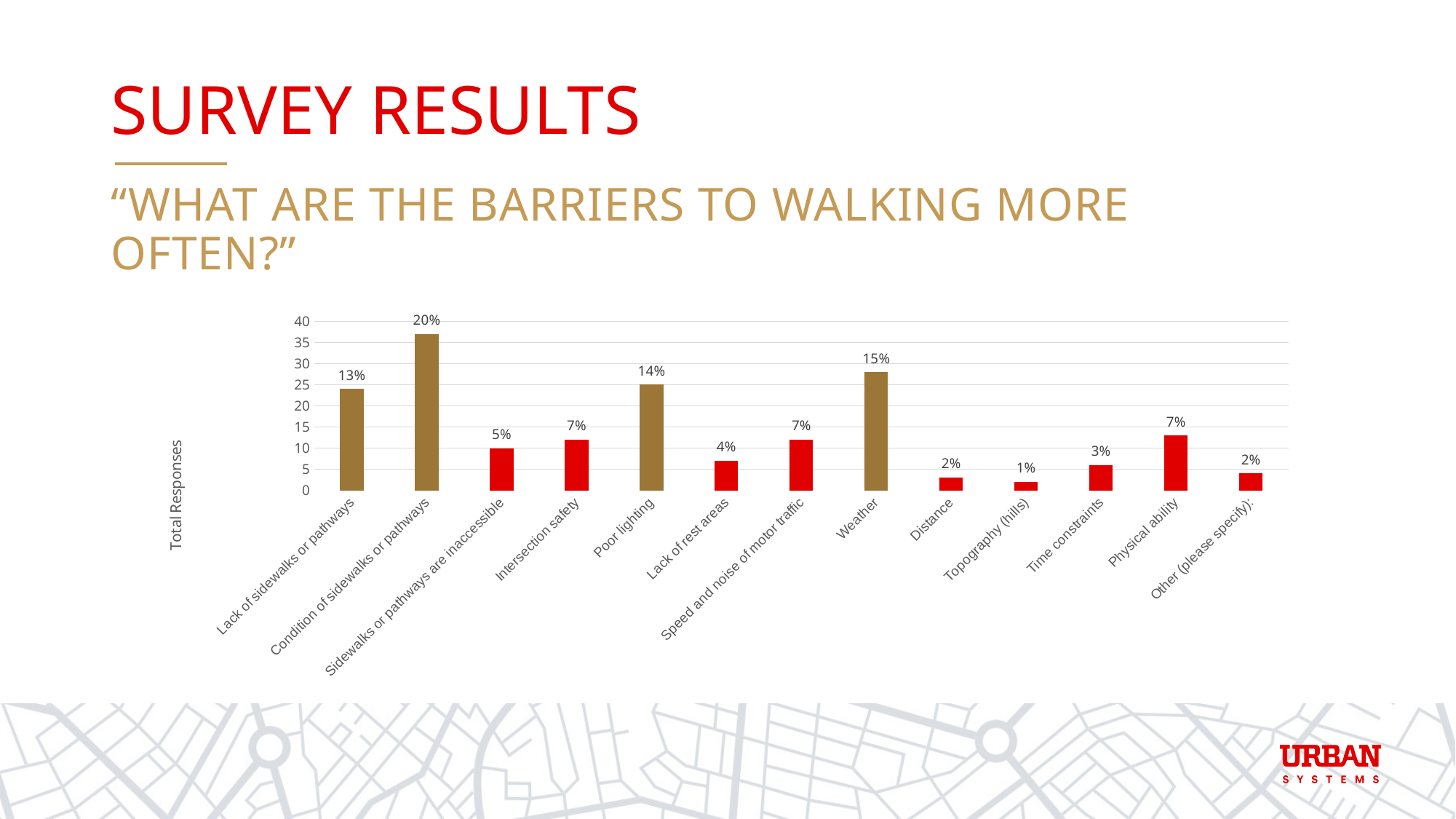
What percentage label is shown for "Lack of rest areas"? 4% Which has a higher percentage label, "Weather" or "Poor lighting"? Weather Which barrier has the lowest number of responses? Topography (hills) What percentage label is shown for "Weather"? 15% Is the number of total responses for "Intersection safety" greater or less than 15? less How many barrier categories are shown on the x axis? 13 Which barrier has the highest number of responses? Condition of sidewalks or pathways What is the difference in percentage points between "Condition of sidewalks or pathways" and "Lack of sidewalks or pathways"? 7% Is the number of total responses for "Weather" greater or less than 25? greater What percentage label is shown for "Time constraints"? 3% What kind of chart is used to show the survey results? Bar chart What percentage label is shown for "Condition of sidewalks or pathways"? 20%